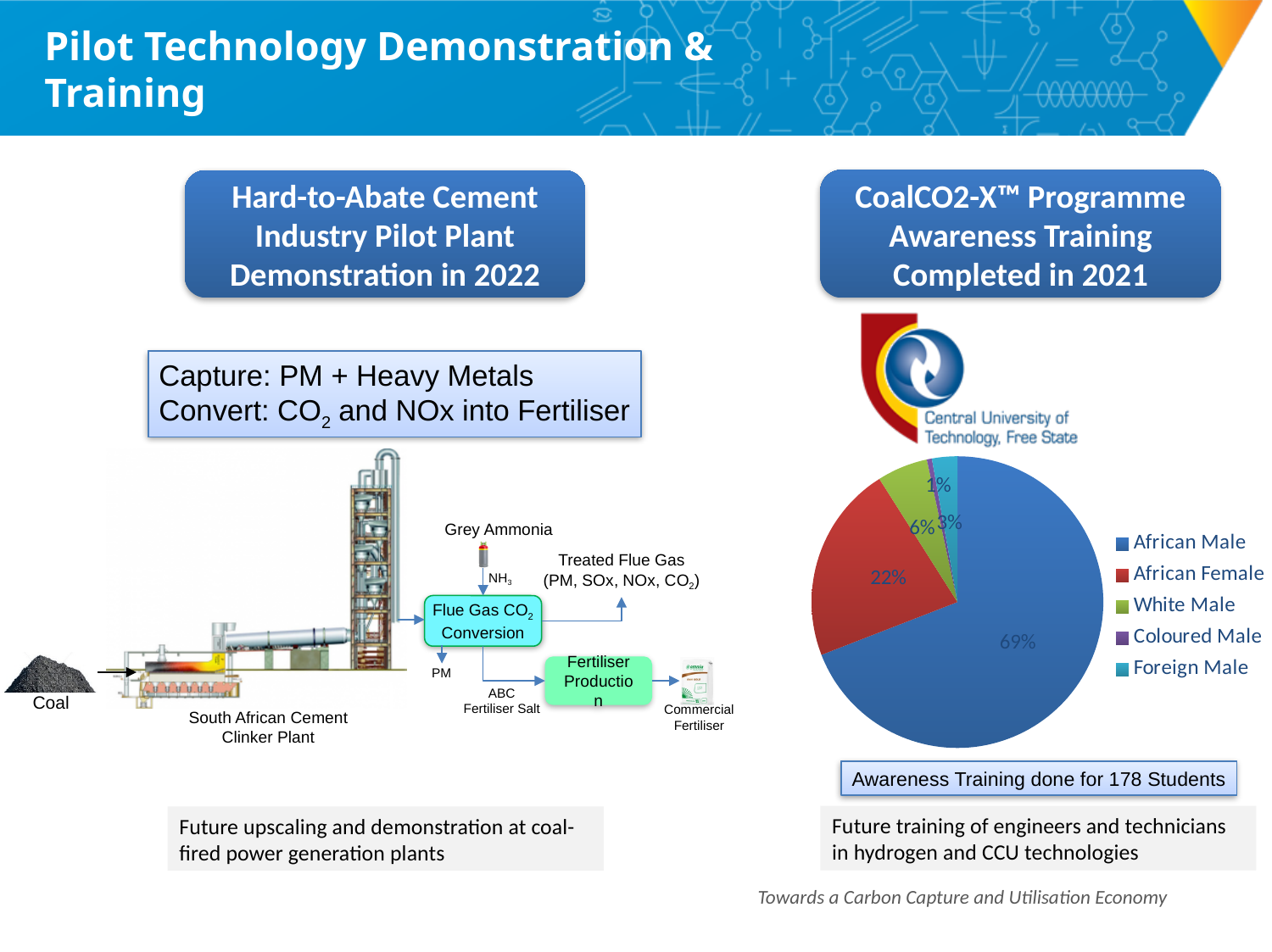
Which legend entry is listed last in the pie chart's legend? Foreign Male Which category has the largest slice in the pie chart? African Male In the pie chart, what percentage is shown for African Male? 69% Is the share for African Male in the pie chart greater or less than 50%? greater In the pie chart, what percentage is shown for White Male? 6% In the pie chart, what percentage is shown for African Female? 22% How many categories does the pie chart's legend list? 5 In the pie chart, by how many percentage points does African Male exceed African Female? 47 percentage points What colour is the African Female slice in the pie chart? red What is the smallest percentage labelled on the pie chart? 1% In the pie chart, which is larger: the share for African Female or the share for White Male? African Female What kind of chart is shown on the right side of the slide under the Central University of Technology logo? pie chart